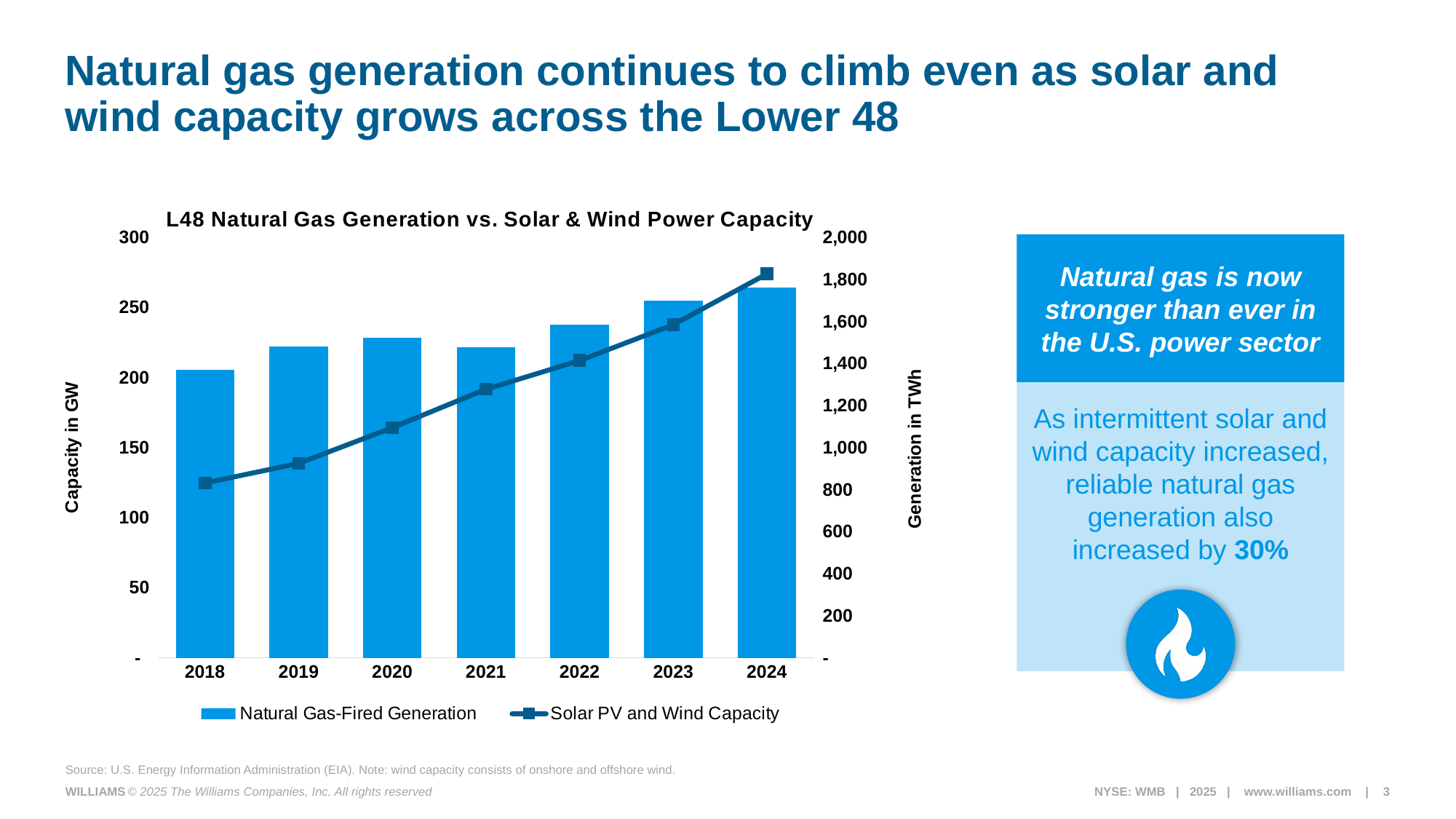
What is the title of the chart on the slide? L48 Natural Gas Generation vs. Solar & Wind Power Capacity Which year has the lowest Solar PV and Wind Capacity value? 2018 What kind of chart is shown on the slide? A combination bar and line chart Is the Solar PV and Wind Capacity value for 2024 greater or less than 250 GW? greater How many years are shown on the x axis of the chart? 7 How many series does the chart legend list? 2 Which year has the lowest Natural Gas-Fired Generation bar? 2018 Which year has the larger Natural Gas-Fired Generation bar, 2022 or 2023? 2023 Does Solar PV and Wind Capacity rise or fall from 2018 to 2024? Rise Is the Natural Gas-Fired Generation value for 2018 greater or less than 1,200 TWh? greater Which year has the highest Natural Gas-Fired Generation bar? 2024 Is the Solar PV and Wind Capacity value for 2018 greater or less than 150 GW? less